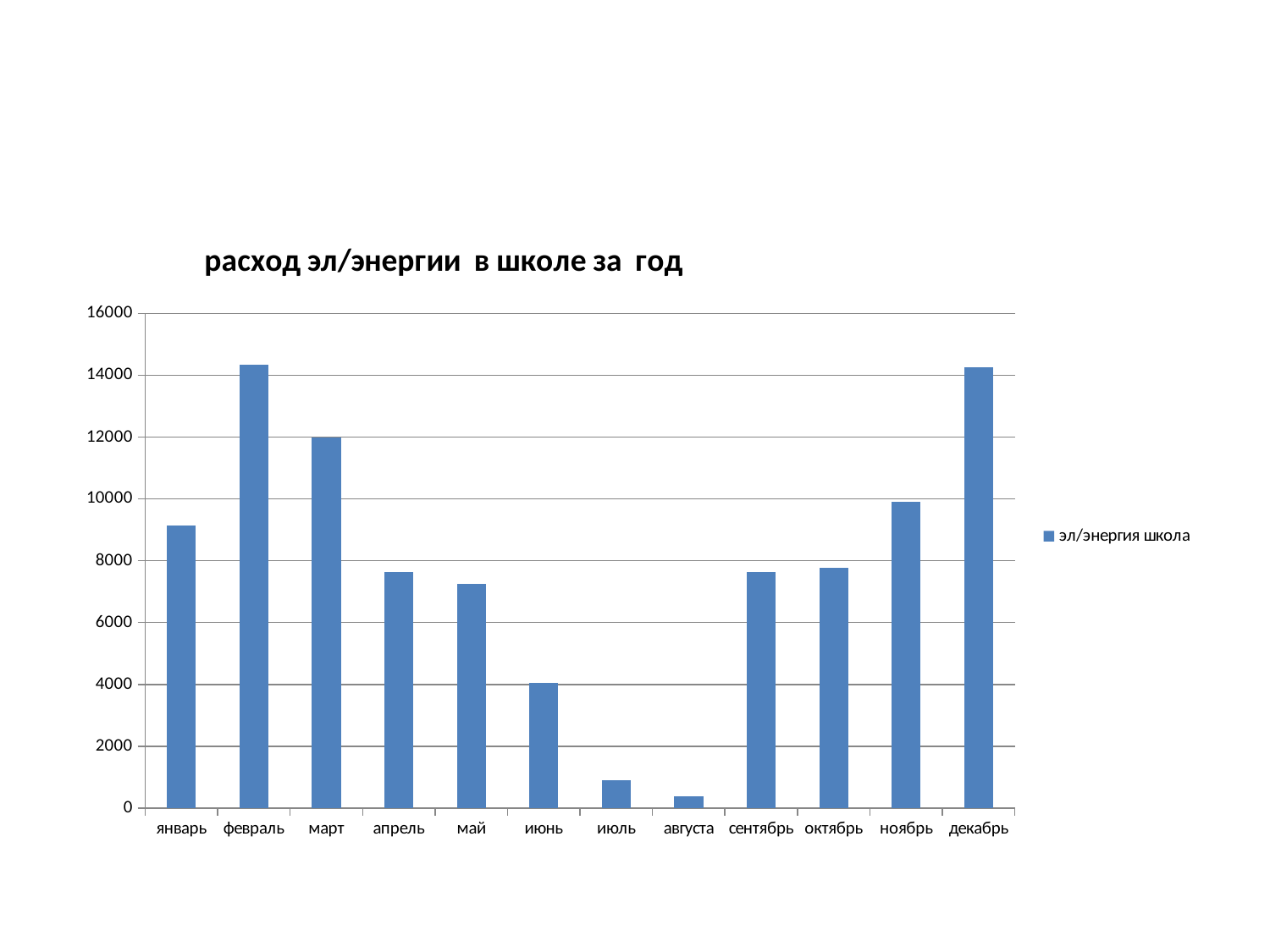
Do the values rise or fall from март to августа? fall Is the value for июль greater or less than 2000? less How many series does the legend list? 1 Which is larger, the value for январь or the value for ноябрь? ноябрь Is the value for май greater or less than 8000? less Is the value for декабрь greater or less than 14000? greater Which month has the lowest value? августа What kind of chart is shown on the slide? bar chart What is the title of the chart? расход эл/энергии в школе за год How many months (categories) are shown on the x axis? 12 Which is larger, the value for май or the value for июнь? май